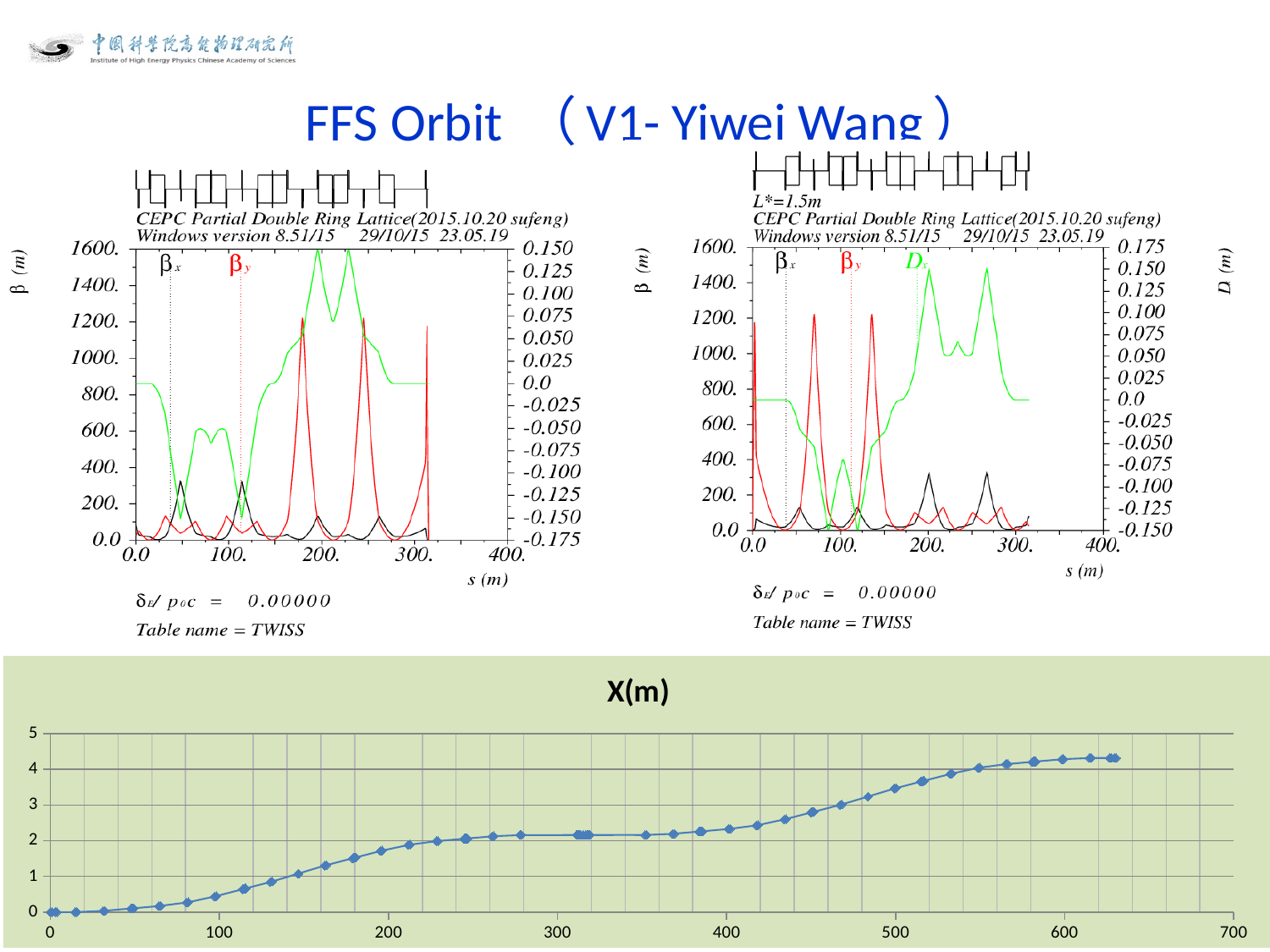
In the bottom chart titled X(m), is the value at x = 100 greater or less than 1? less What is the title of the bottom chart? X(m) In the bottom chart titled X(m), is the value at x = 600 greater or less than 4? greater What kind of chart is the bottom chart titled X(m)? line chart What kind of chart is the top-left chart (CEPC Partial Double Ring Lattice)? line chart How many series are labelled in the top-right chart (βx, βy, Dx)? 3 What is the highest tick value on the right-hand axis of the top-right chart? 0.175 In the bottom chart titled X(m), do the values rise or fall as the x axis increases from 0 to 600? rise In the bottom chart titled X(m), is the value at x = 500 greater or less than 3? greater How many series are labelled in the top-left chart (βx, βy)? 2 In the bottom chart titled X(m), which has the larger value: x = 400 or x = 200? x = 400 In the bottom chart titled X(m), where along the x axis is the highest value found: near the left end or near the right end? near the right end